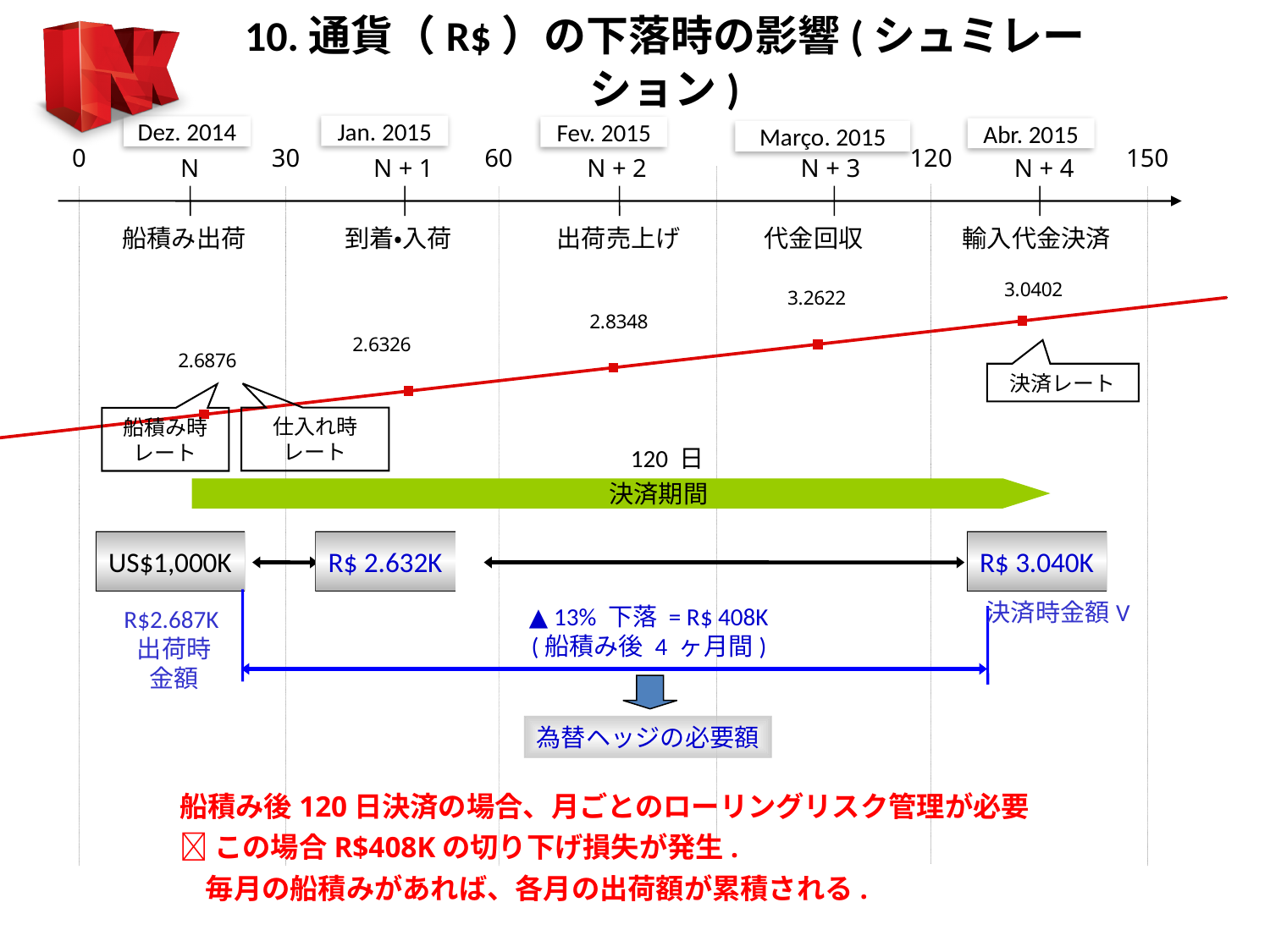
What is the difference between the labeled values at Dez. 2014 (2.6876) and Jan. 2015 (2.6326)? 0.0550 What is the exchange rate value labeled at Dez. 2014 (N) on the chart? 2.6876 How many labeled data points are shown on the exchange rate line? 5 What is the exchange rate value labeled at Fev. 2015 (N + 2) on the chart? 2.8348 Which is larger, the labeled value at Fev. 2015 or at Jan. 2015? Fev. 2015 What is the exchange rate value labeled at Abr. 2015 (N + 4), the 決済レート, on the chart? 3.0402 What is the exchange rate value labeled at Jan. 2015 (N + 1) on the chart? 2.6326 Which month has the highest labeled exchange rate value on the chart? Março. 2015 Does the red exchange rate line rise or fall from left to right across the chart? rise Which month has the lowest labeled exchange rate value on the chart? Jan. 2015 What is the exchange rate value labeled at Março. 2015 (N + 3) on the chart? 3.2622 What is the difference between the labeled values at Abr. 2015 (3.0402) and Dez. 2014 (2.6876)? 0.3526